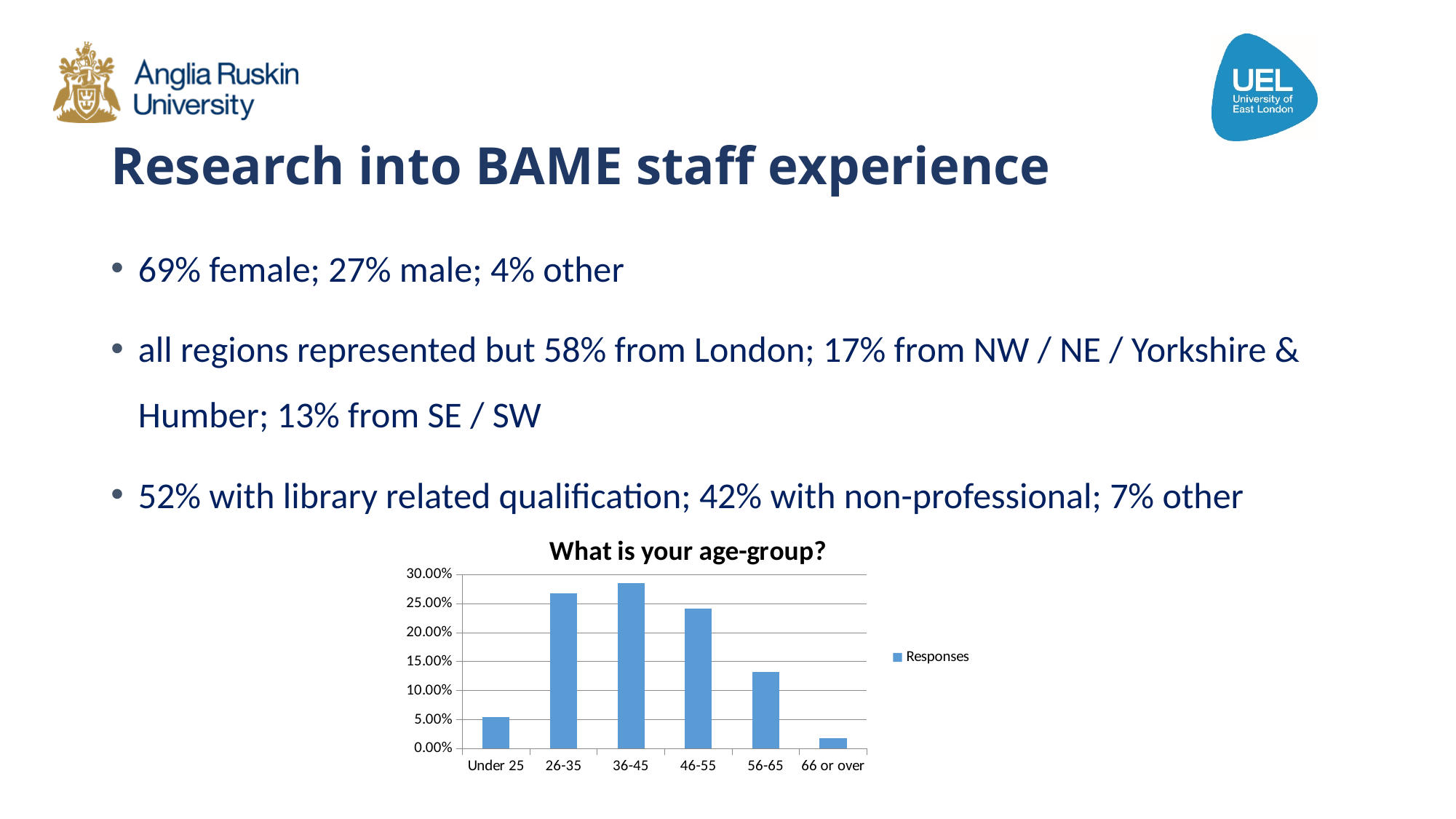
Do the values rise or fall along the x axis from 36-45 to 66 or over? fall Is the value for Under 25 greater or less than 10.00%? less How many age-group categories are shown on the x axis of the chart? 6 Is the value for 46-55 greater or less than 20.00%? greater Is the value for 66 or over greater or less than 5.00%? less How many series does the chart's legend list? 1 Which age group has the lowest share of responses in the chart? 66 or over What kind of chart is shown under the title "What is your age-group?"? bar chart What is the name of the series shown in the chart's legend? Responses Which has the larger share of responses, 46-55 or 56-65? 46-55 Which age group has the highest share of responses in the chart? 36-45